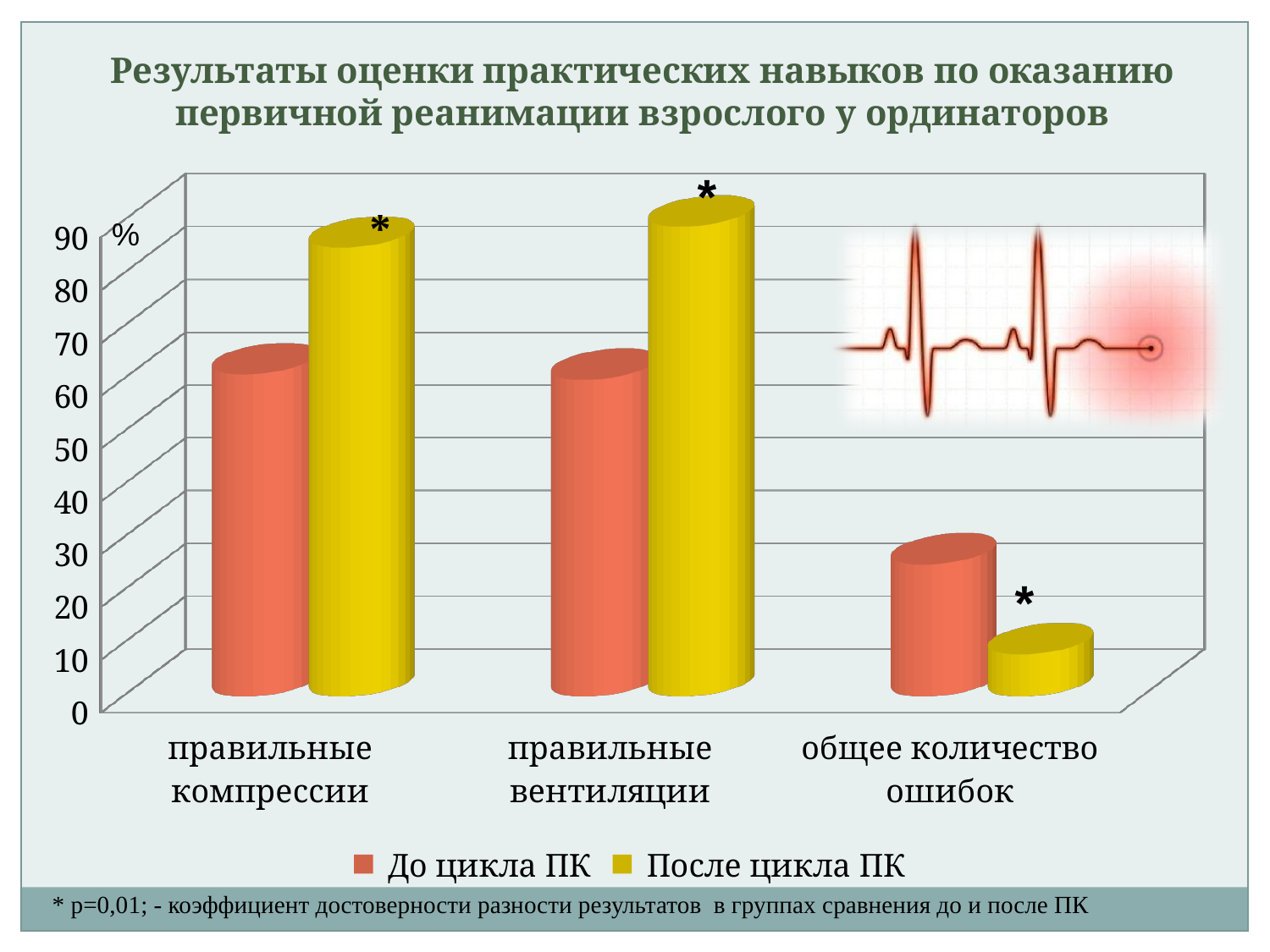
Is the value for 'правильные вентиляции' in the 'После цикла ПК' series greater or less than 80? greater What kind of chart is shown on the slide? bar chart Is the value for 'правильные компрессии' in the 'После цикла ПК' series greater or less than 70? greater How many series does the chart legend list? 2 For 'правильные компрессии', which series has the larger value: 'До цикла ПК' or 'После цикла ПК'? После цикла ПК Is the value for 'общее количество ошибок' in the 'До цикла ПК' series greater or less than 40? less What unit is shown on the vertical axis of the chart? % What are the two series named in the chart legend? До цикла ПК, После цикла ПК How many categories are shown on the x axis of the chart? 3 For 'общее количество ошибок', which series has the larger value: 'До цикла ПК' or 'После цикла ПК'? До цикла ПК